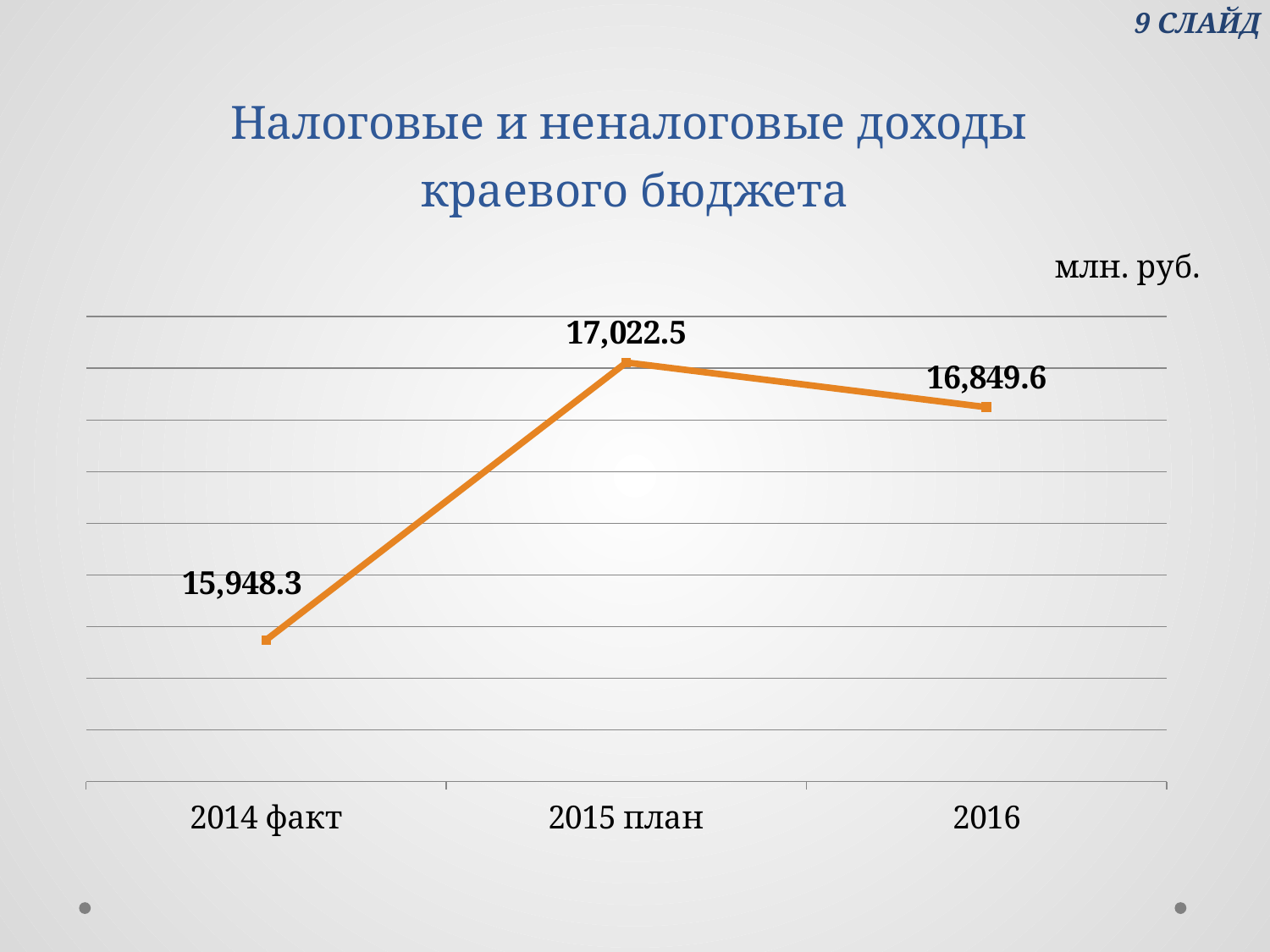
What is the value for 2016? 16,849.6 What is the difference between the values for 2015 план and 2016? 172.9 How many data points are plotted on the chart? 3 Which category has the highest value? 2015 план What is the value for 2015 план? 17,022.5 Which is larger, the value for 2016 or the value for 2014 факт? 2016 What unit is indicated for the chart values? млн. руб. What kind of chart is shown on the slide? line chart Which category has the lowest value? 2014 факт What is the value for 2014 факт? 15,948.3 Does the value rise or fall from 2015 план to 2016? fall What is the difference between the values for 2015 план and 2014 факт? 1,074.2